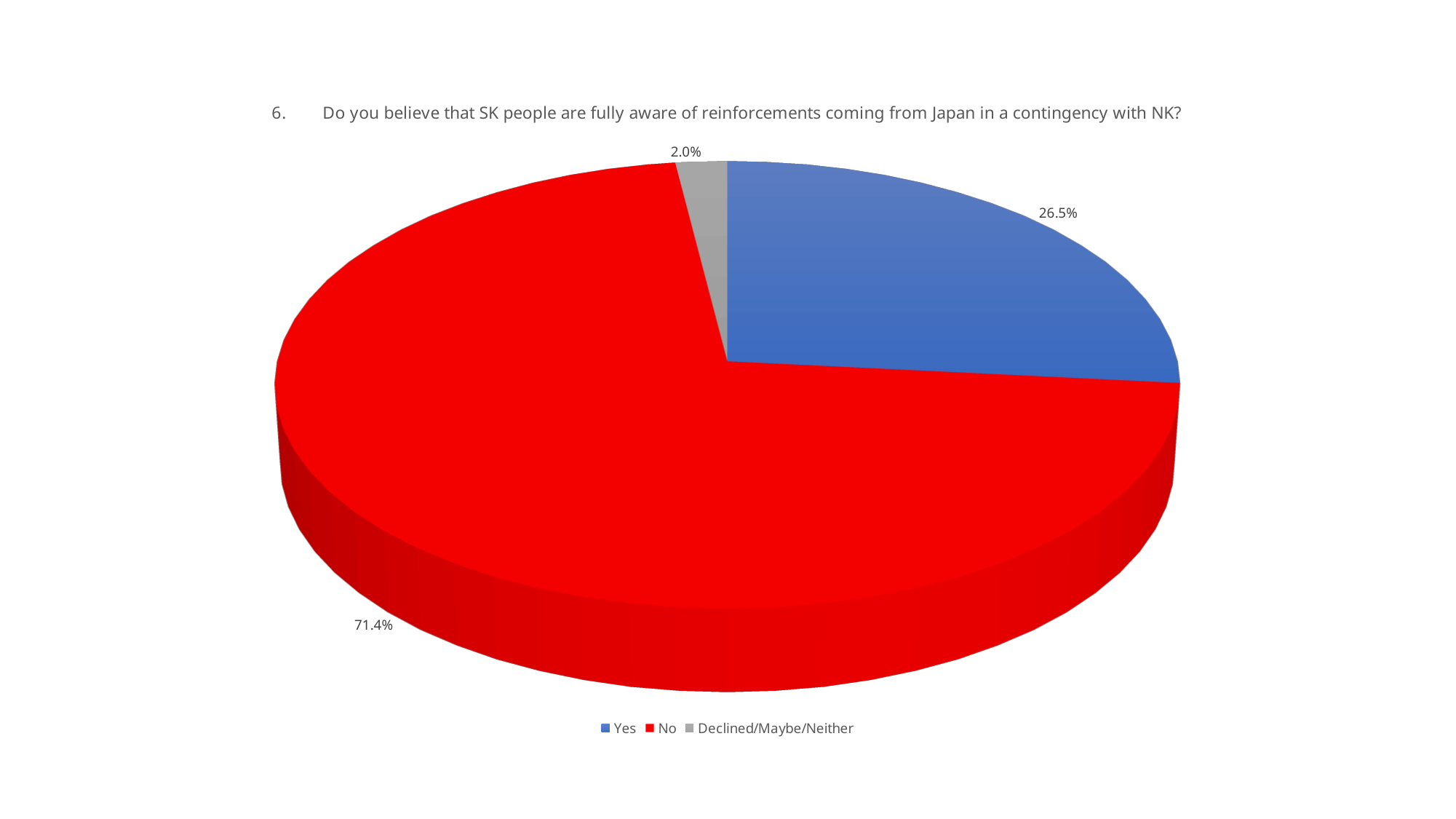
What kind of chart is shown on the slide? Pie chart What question does the chart title ask? Do you believe that SK people are fully aware of reinforcements coming from Japan in a contingency with NK? What percentage of respondents answered "Declined/Maybe/Neither"? 2.0% What colour is the "No" slice? Red How many slices does the pie chart have? 3 How many entries does the legend list? 3 What percentage of respondents answered "No"? 71.4% What is the difference in percentage points between the "No" and "Yes" shares? 44.9 Which is larger, the share for "Yes" or the share for "No"? No Which response has the smallest share of the pie? Declined/Maybe/Neither What percentage of respondents answered "Yes"? 26.5% Which response has the largest share of the pie? No